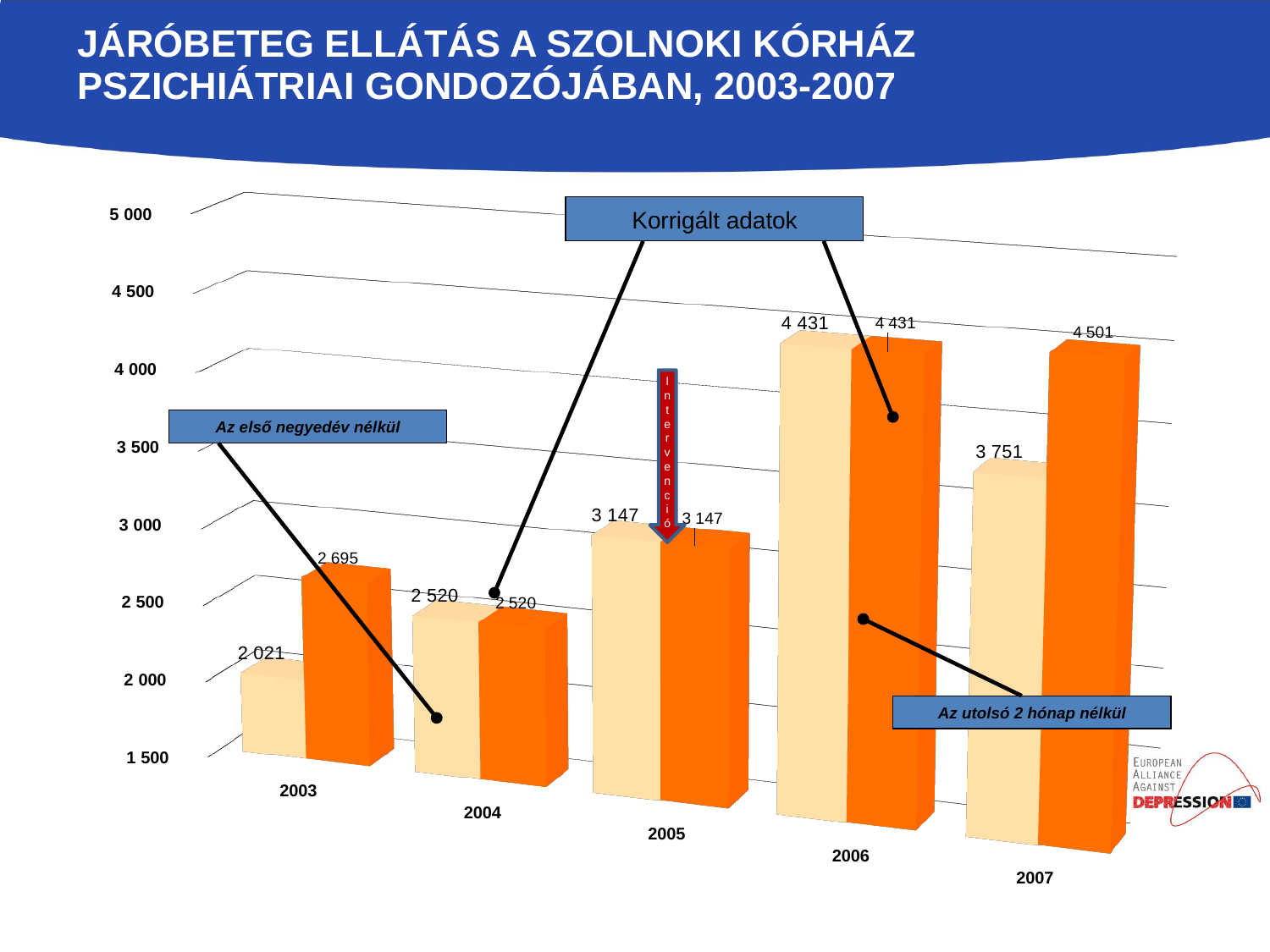
How many years are shown on the x axis of the chart? 5 What is the value shown for 2005? 3 147 What is the value of the light-coloured bar for 2007? 3 751 What is the value of the orange bar for 2007? 4 501 What is the value of the light-coloured bar for 2003? 2 021 What does the label in the box at the top of the chart say? Korrigált adatok What type of chart is shown on the slide? bar chart What is the difference between the orange bar and the light-coloured bar for 2007? 750 Which year has the highest orange bar? 2007 Which year has the lowest light-coloured bar? 2003 What is the value of the orange bar for 2003? 2 695 Which is larger for 2003, the orange bar or the light-coloured bar? the orange bar